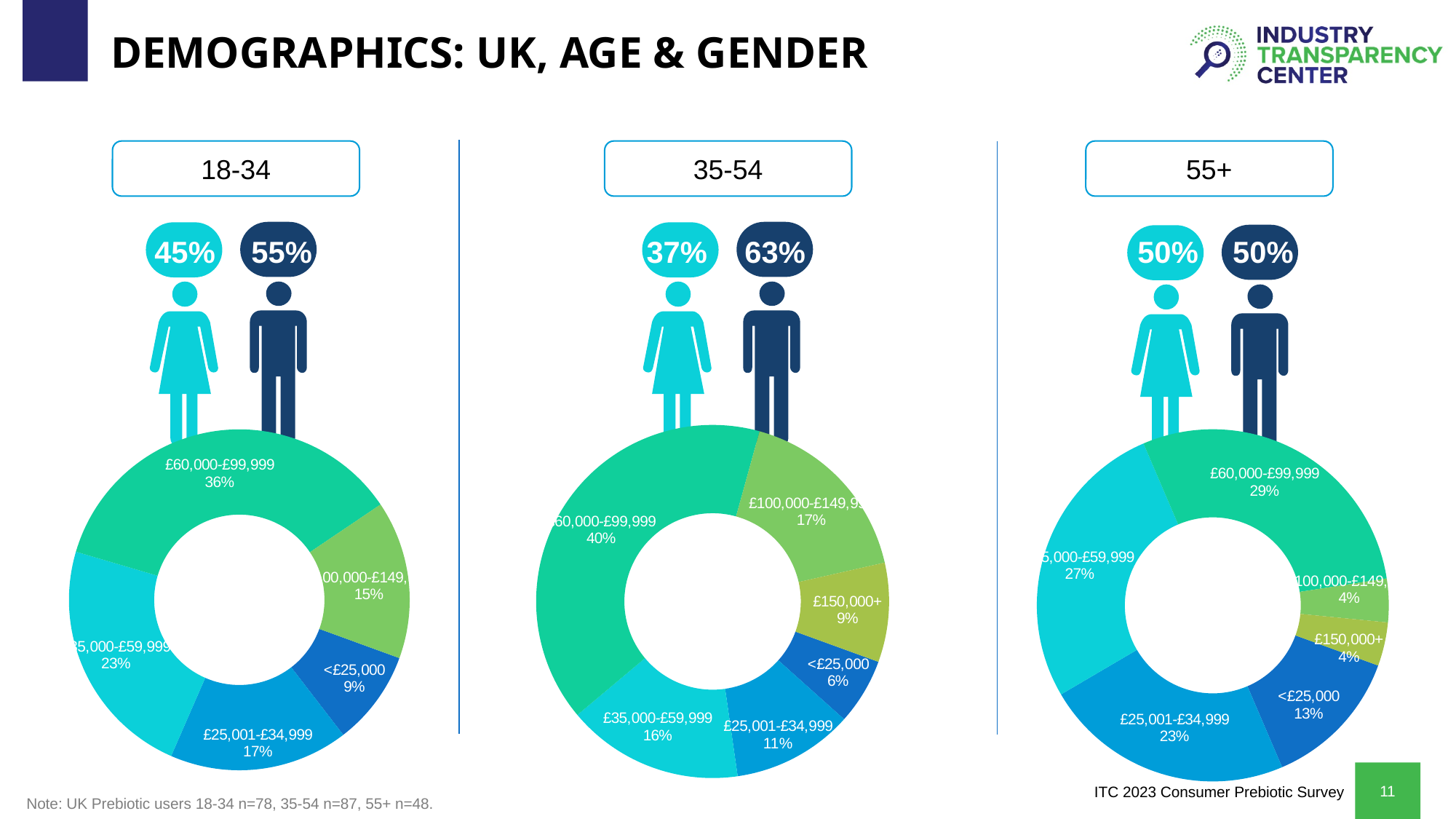
In the 18-34 donut chart, what share is £60,000-£99,999? 36% In the 55+ donut chart, what is the difference between the £35,000-£59,999 share and the <£25,000 share? 14 percentage points What type of chart is used to show income brackets for each age group? Donut (pie) chart In the 35-54 donut chart, what share is £100,000-£149,999? 17% What is the female percentage shown for the 35-54 age group? 37% How many income brackets are shown in the 55+ donut chart? 6 How many income brackets are shown in the 18-34 donut chart? 5 In the 35-54 donut chart, what share is £150,000+? 9% In the 35-54 donut chart, which income bracket has the largest share? £60,000-£99,999 In the 18-34 donut chart, which income bracket has the smallest share? <£25,000 In the 55+ donut chart, what share is £25,001-£34,999? 23% In the 35-54 donut chart, which is larger: £35,000-£59,999 or £25,001-£34,999? £35,000-£59,999